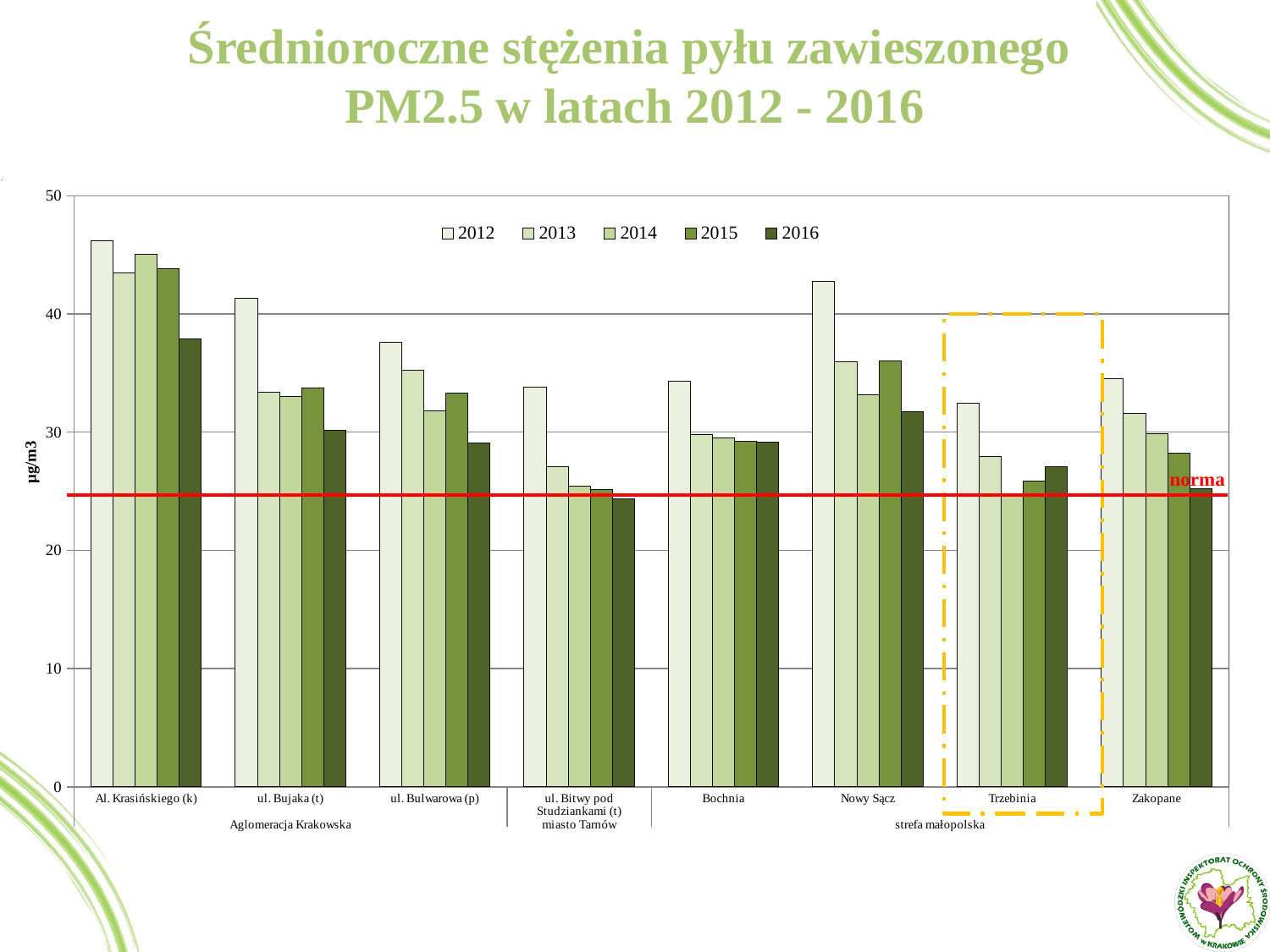
Do the values for Zakopane rise or fall from 2012 to 2016? fall What label is written next to the red horizontal line on the chart? norma Is the 2016 value for ul. Bitwy pod Studziankami (t) greater or less than 30? less How many series does the legend list? 5 Is the 2015 value for Trzebinia greater or less than 30? less Which is larger, the 2012 value for Nowy Sącz or the 2012 value for Bochnia? Nowy Sącz For Nowy Sącz, which year has the highest value? 2012 How many measurement stations (categories) are shown on the x axis? 8 Which station has the highest 2012 value? Al. Krasińskiego (k) Is the 2012 value for Nowy Sącz greater or less than 40? greater What kind of chart is shown on the slide? bar chart